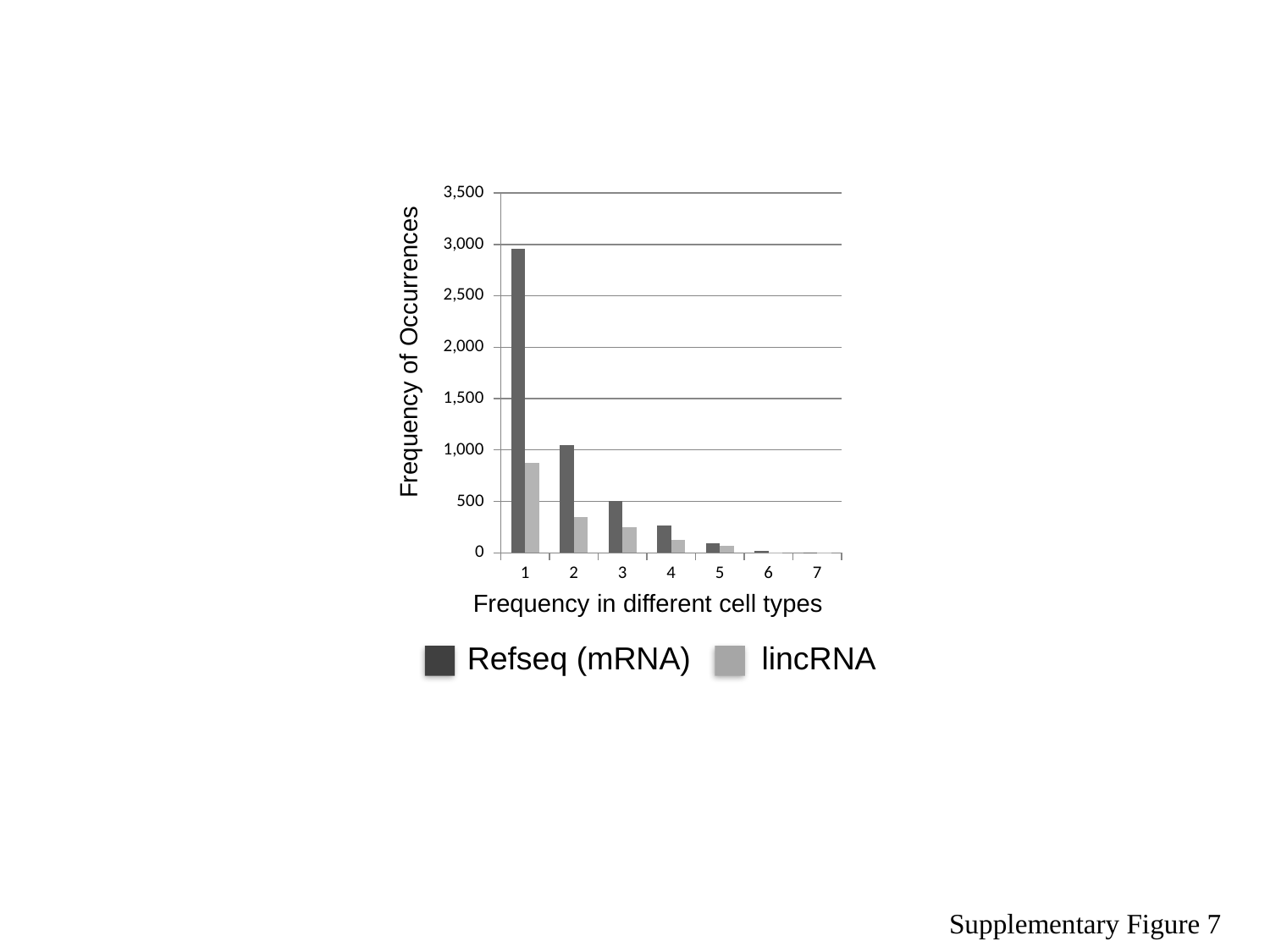
Which category has the highest value for Refseq (mRNA)? 1 What kind of chart is shown on the slide? bar chart Is the Refseq (mRNA) value for category 4 greater or less than 500? less Is the Refseq (mRNA) value for category 1 greater or less than 2,500? greater How many series does the legend list? 2 For category 1, which series has the larger value, Refseq (mRNA) or lincRNA? Refseq (mRNA) Is the lincRNA value for category 1 greater or less than 1,000? less What is the title of the y axis? Frequency of Occurrences How many categories are shown along the x axis? 7 Which category has the highest value for lincRNA? 1 Do the Refseq (mRNA) values rise or fall as the frequency in different cell types increases from 1 to 7? fall